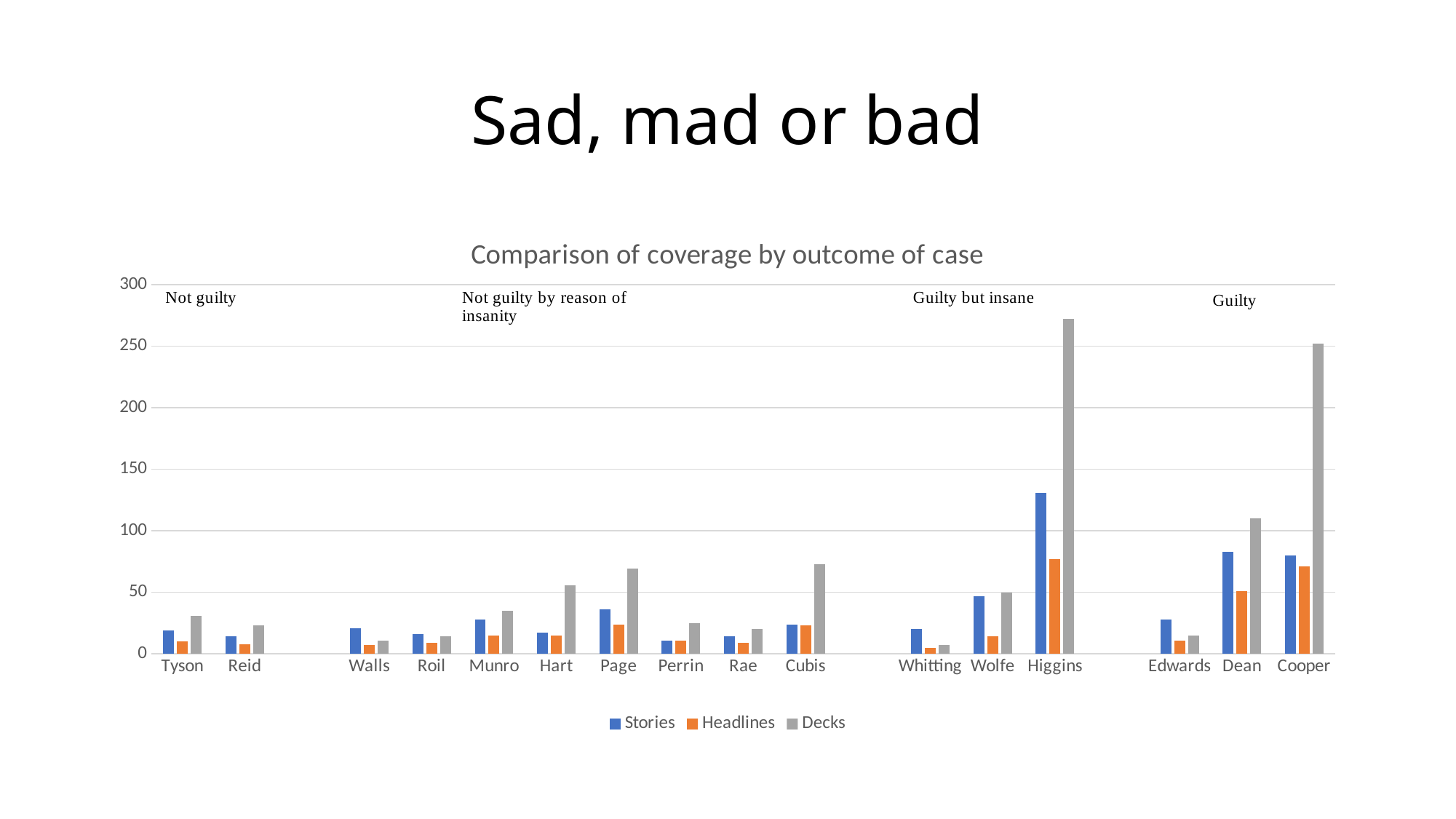
Which case has the lowest Headlines value? Whitting Is the Stories value for Higgins greater or less than 100? greater Which is larger, the Decks value for Higgins or the Decks value for Cooper? Higgins Which case has the highest Stories value? Higgins What is the title of the chart? Comparison of coverage by outcome of case Is the Decks value for Higgins greater or less than 250? greater How many series does the legend list? 3 Is the Stories value for Tyson greater or less than 50? less What kind of chart is shown on the slide? bar chart How many named cases are labelled on the x axis? 16 Which case has the highest Decks value? Higgins Which is larger, the Decks value for Cubis or the Decks value for Hart? Cubis